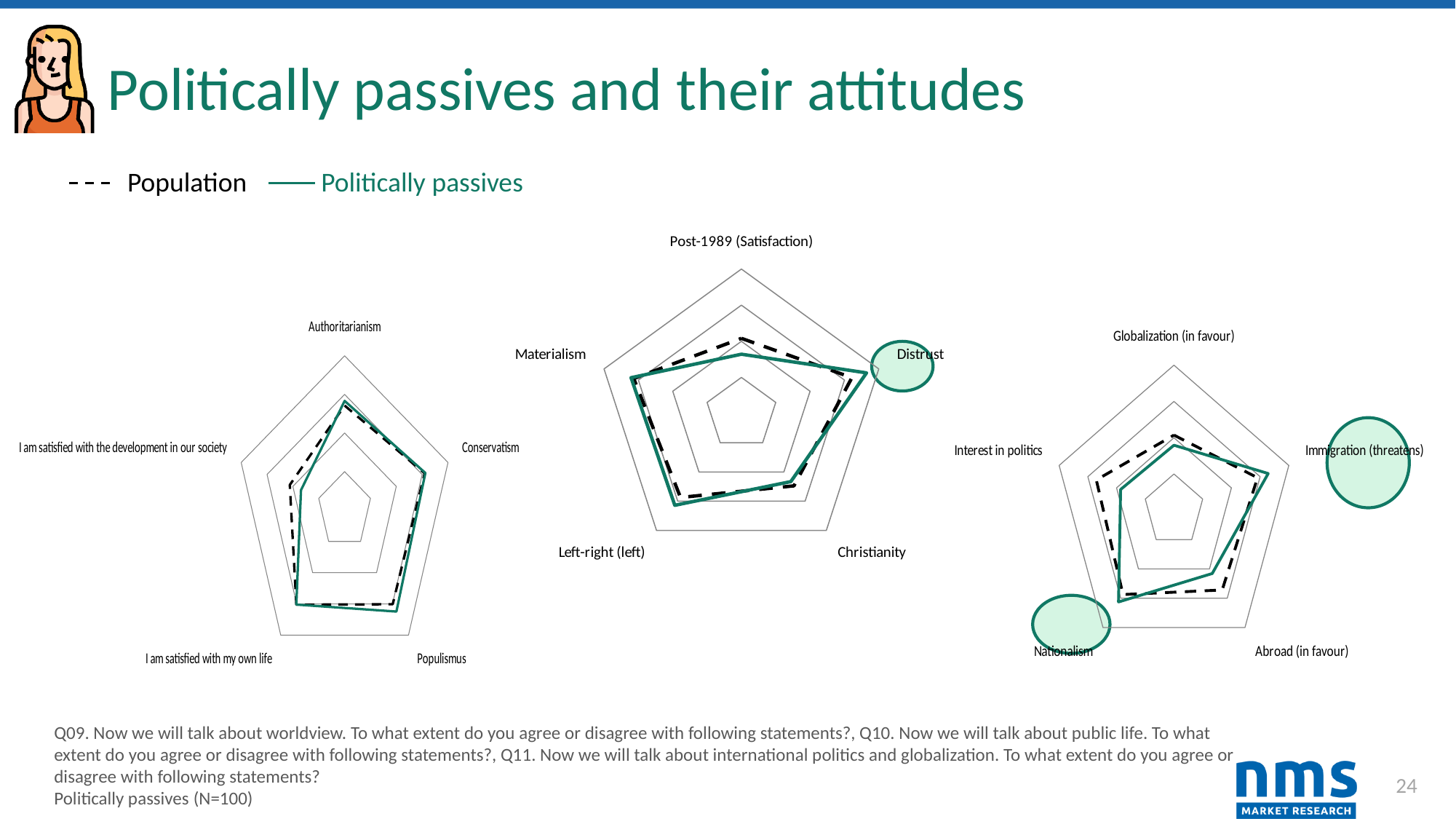
In the middle chart, which series has the higher value for Post-1989 (Satisfaction), Population or Politically passives? Population In the right chart, how many categories (axes) are plotted? 5 In the middle chart, which category has the highest value for Politically passives? Distrust In the middle chart, which category has the lowest value for Politically passives? Post-1989 (Satisfaction) How many series does the legend list? 2 What kind of chart is used on this slide? Radar chart In the left chart, which category has the lowest value for Politically passives? I am satisfied with the development in our society In the middle chart, which series has the higher value for Distrust, Population or Politically passives? Politically passives Which series is drawn with a dashed line? Population In the middle chart, how many categories (axes) are plotted? 5 Which series is drawn with a solid green line? Politically passives In the left chart, how many categories (axes) are plotted? 5